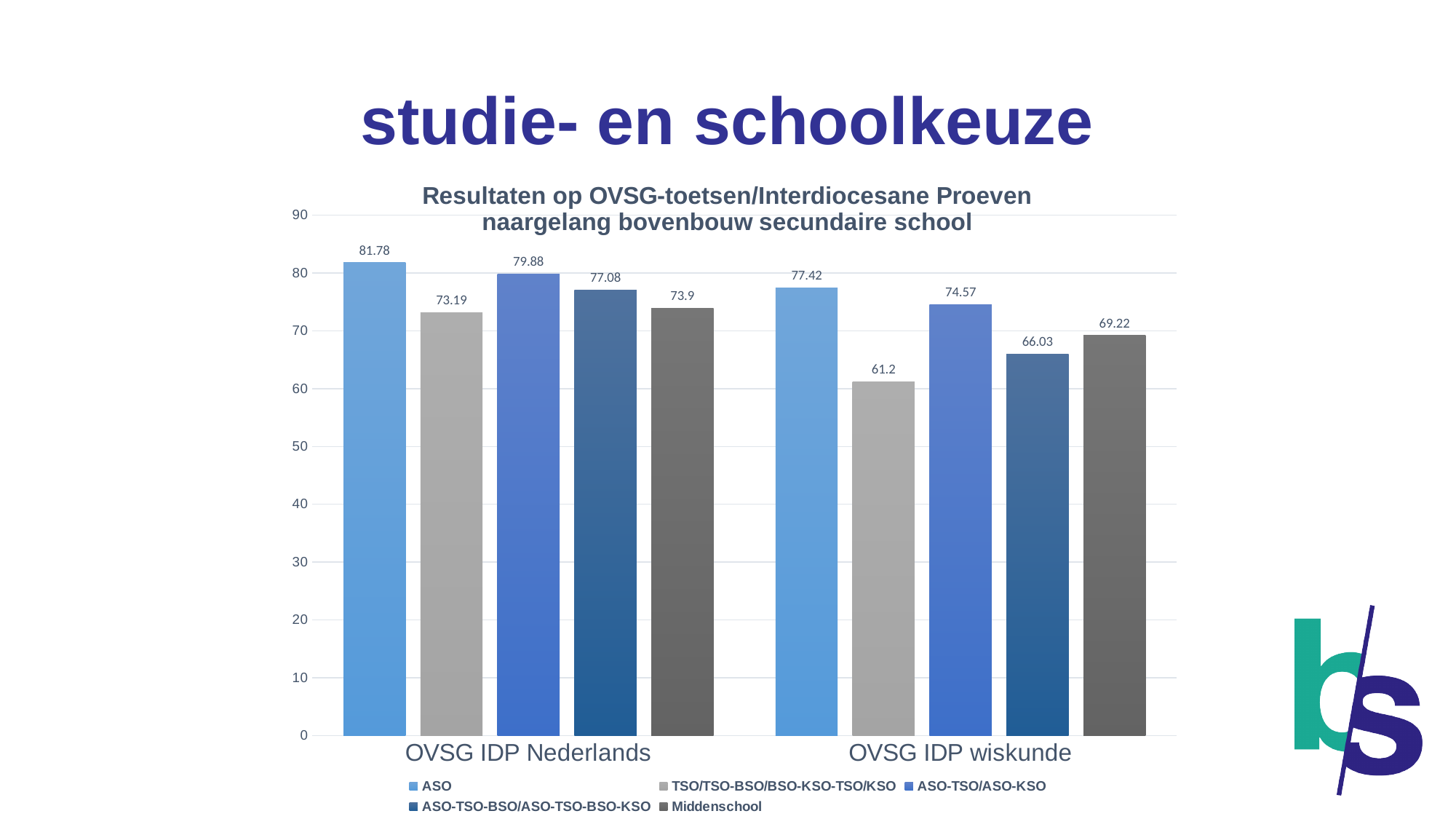
What is the difference between the ASO values for OVSG IDP Nederlands and OVSG IDP wiskunde? 4.36 Which series has the highest value in the OVSG IDP Nederlands category? ASO What is the title of the chart? Resultaten op OVSG-toetsen/Interdiocesane Proeven naargelang bovenbouw secundaire school Which series has the lowest value in the OVSG IDP wiskunde category? TSO/TSO-BSO/BSO-KSO-TSO/KSO What is the value for ASO in the OVSG IDP Nederlands category? 81.78 What kind of chart is shown on the slide? Bar chart What is the value for TSO/TSO-BSO/BSO-KSO-TSO/KSO in the OVSG IDP wiskunde category? 61.2 What is the value for Middenschool in the OVSG IDP wiskunde category? 69.22 How many categories are shown on the x axis? 2 Which is larger: the Middenschool value for OVSG IDP Nederlands or the ASO-TSO/ASO-KSO value for OVSG IDP wiskunde? ASO-TSO/ASO-KSO value for OVSG IDP wiskunde Is the value for ASO-TSO-BSO/ASO-TSO-BSO-KSO in the OVSG IDP wiskunde category greater or less than 70? less How many series does the legend list? 5